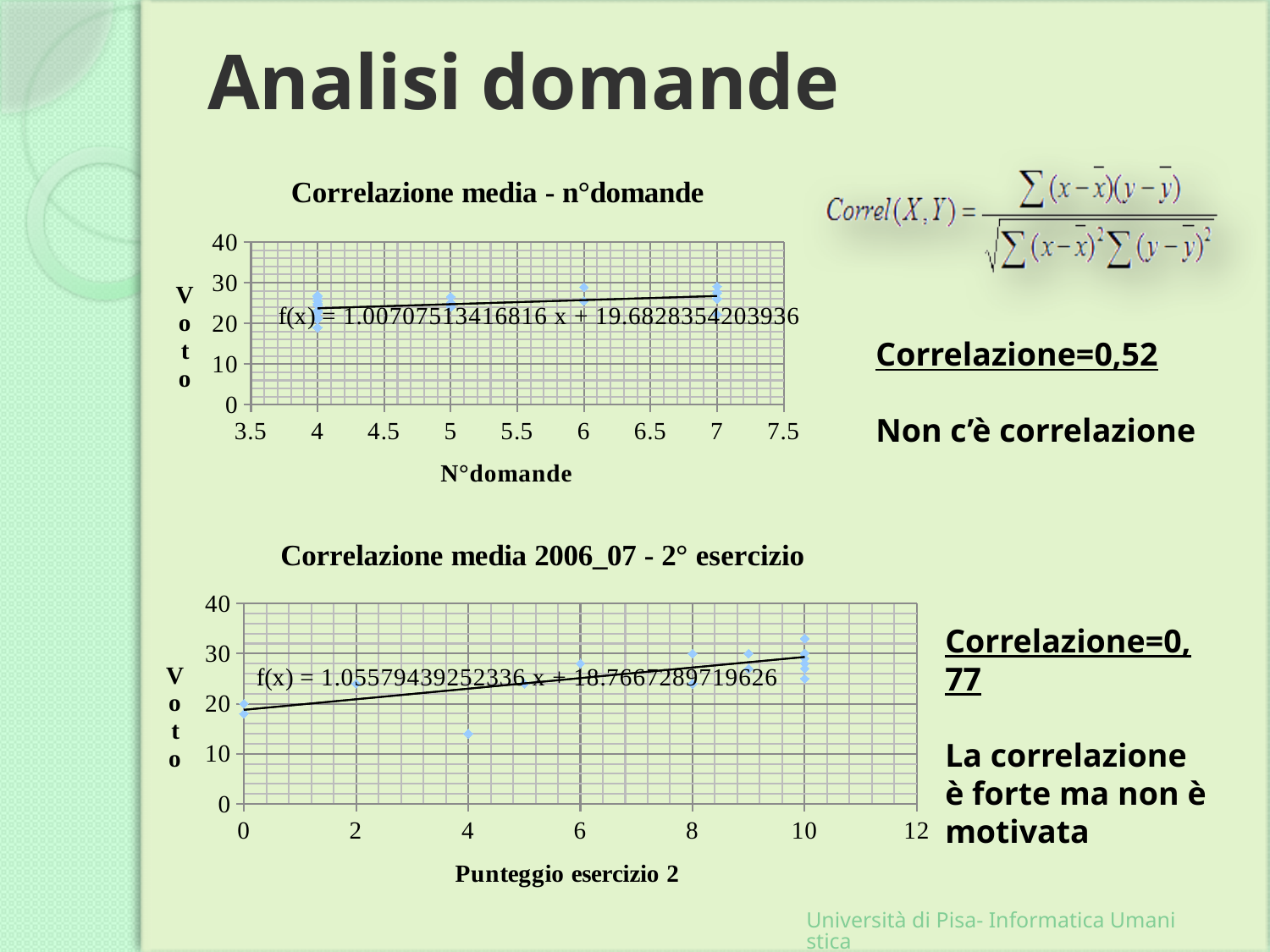
What kind of chart is the top chart titled "Correlazione media - n°domande"? scatter chart In the top chart "Correlazione media - n°domande", are all plotted Voto values less than 40? yes What is the trendline equation shown on the bottom chart "Correlazione media 2006_07 - 2° esercizio"? f(x) = 1.05579439252336 x + 18.7667289719626 What is the x-axis label of the top chart "Correlazione media - n°domande"? N°domande In the bottom chart "Correlazione media 2006_07 - 2° esercizio", does the trendline rise or fall as Punteggio esercizio 2 increases? rise What kind of chart is the bottom chart titled "Correlazione media 2006_07 - 2° esercizio"? scatter chart In the top chart "Correlazione media - n°domande", is the Voto value of the point at N°domande = 7 greater or less than 20? greater In the top chart "Correlazione media - n°domande", does the trendline rise or fall as N°domande increases? rise What is the x-axis label of the bottom chart "Correlazione media 2006_07 - 2° esercizio"? Punteggio esercizio 2 What is the trendline equation shown on the top chart "Correlazione media - n°domande"? f(x) = 1.00707513416816 x + 19.6828354203936 In the bottom chart "Correlazione media 2006_07 - 2° esercizio", are the Voto values of the points at Punteggio esercizio 2 = 10 greater or less than 20? greater